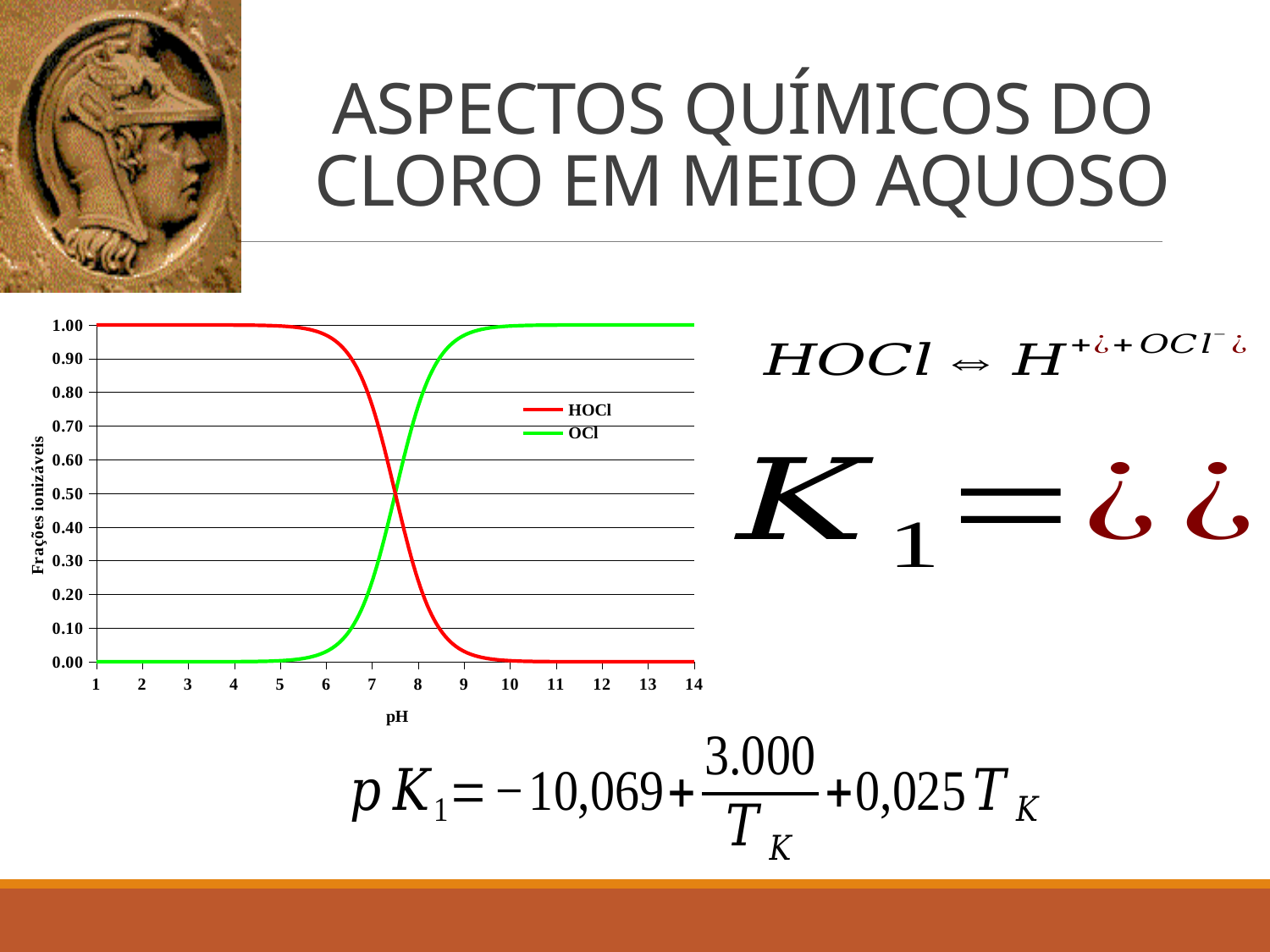
Is the value of the HOCl series at pH 9 greater or less than 0.10? less At pH 9, which series has the larger value, HOCl or OCl? OCl Is the value of the HOCl series at pH 5 greater or less than 0.90? greater At pH 6, which series has the larger value, HOCl or OCl? HOCl What is the label of the x axis of the chart? pH Which two series are listed in the chart legend? HOCl and OCl How many series does the chart legend list? 2 How many pH values are marked along the x axis of the chart? 14 What kind of chart is shown on the slide? line chart Does the OCl series rise or fall as pH increases along the x axis? rise Is the value of the OCl series at pH 6 greater or less than 0.10? less Does the HOCl series rise or fall as pH increases along the x axis? fall